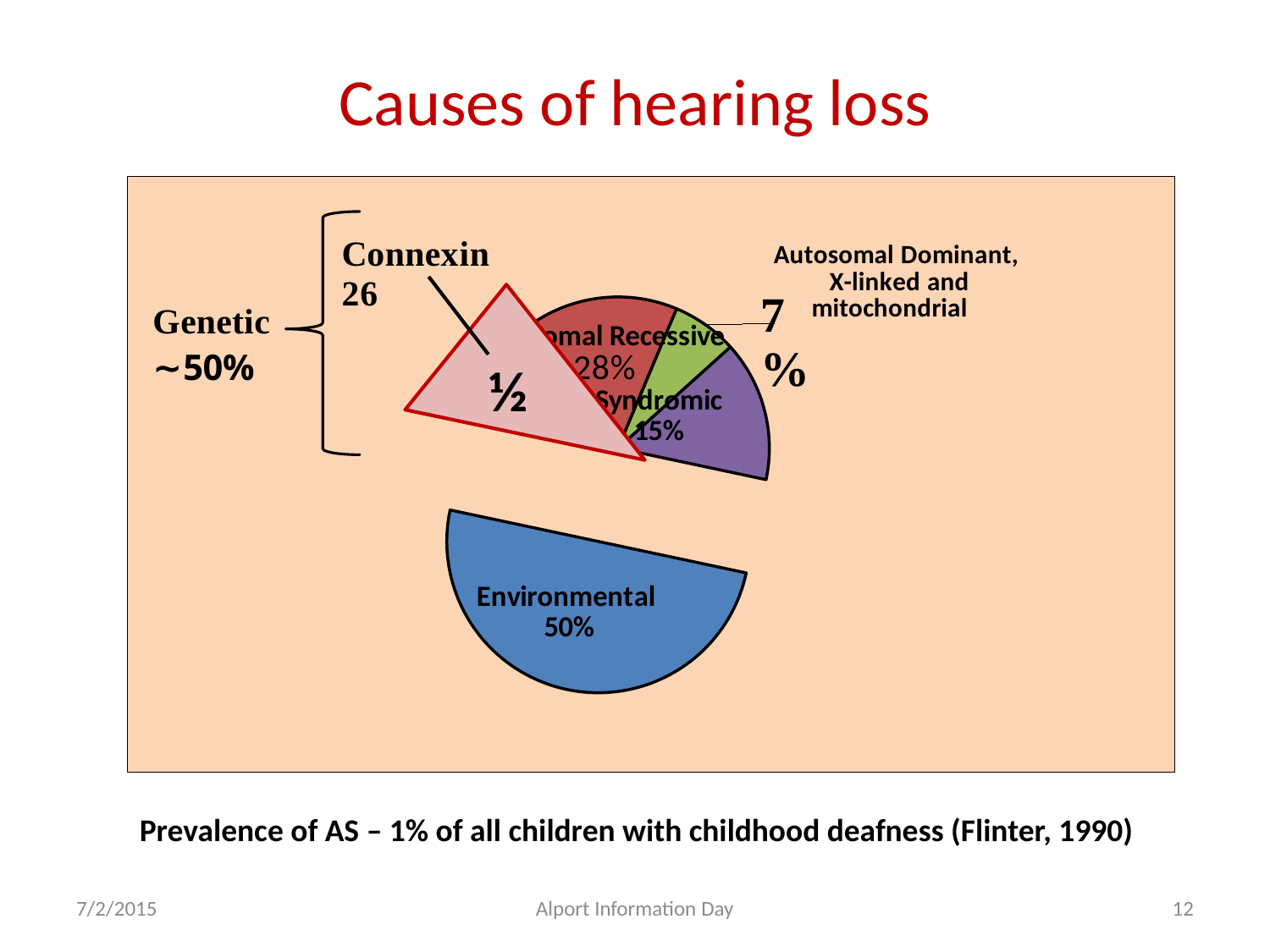
How many slices does the pie chart have? 4 What is the title of the chart on the slide? Causes of hearing loss What percentage of hearing loss is attributed to Environmental causes? 50% What percentage of hearing loss is attributed to Syndromic causes? 15% Which slice of the pie chart is the smallest? Autosomal Dominant, X-linked and mitochondrial Which is larger, the Syndromic slice or the Autosomal Dominant, X-linked and mitochondrial slice? Syndromic What kind of chart is shown on the slide? pie chart What is the difference between the Environmental share and the Syndromic share? 35% Which slice of the pie chart is the largest? Environmental What percentage is shown for the Autosomal Recessive slice? 28% What colour is the Environmental slice of the pie chart? blue What percentage is shown for the Autosomal Dominant, X-linked and mitochondrial slice? 7%